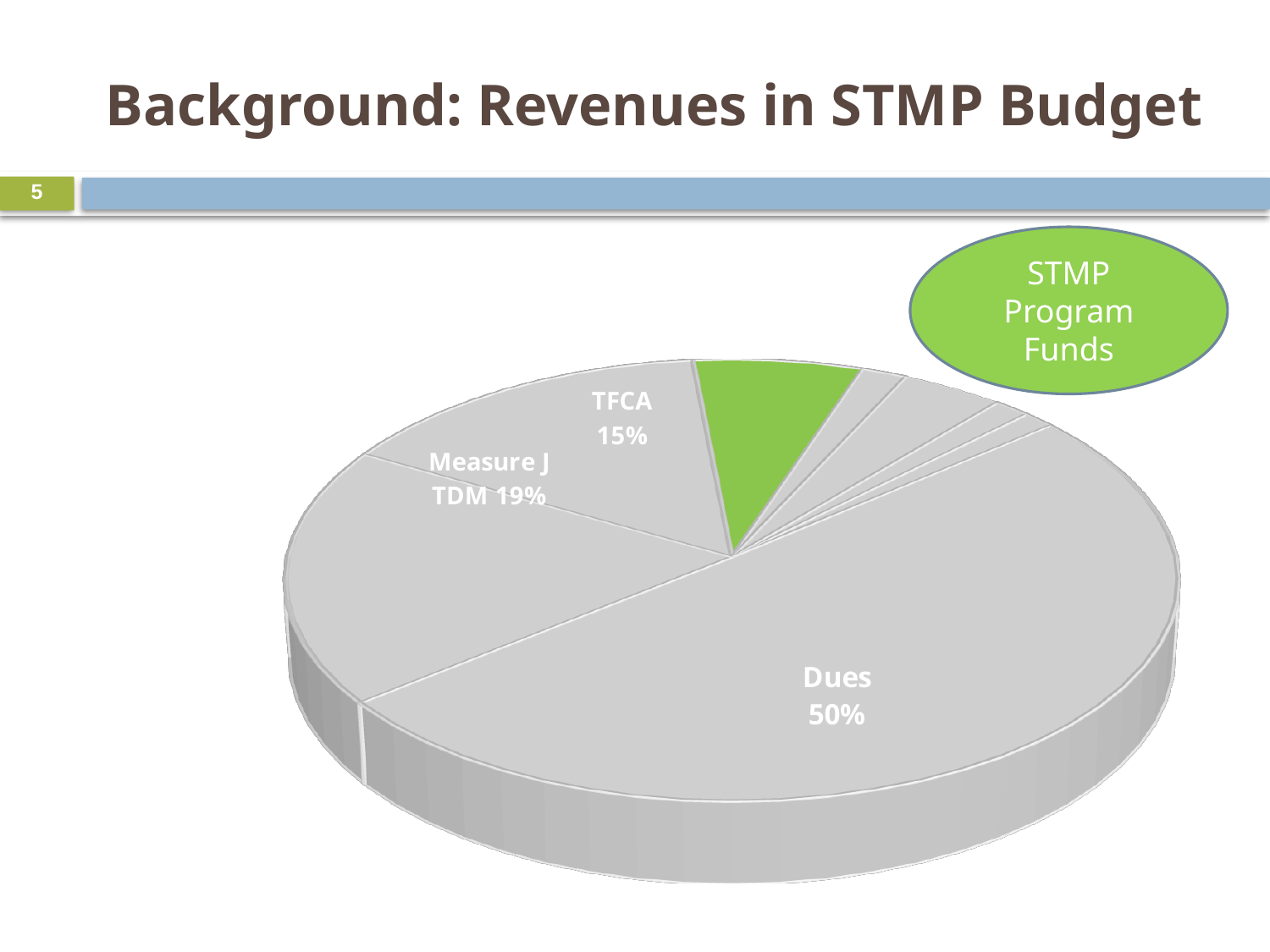
Which slice of the pie is coloured green? STMP Program Funds What share of the STMP budget revenues comes from Dues? 50% What kind of chart is shown on the slide? Pie chart Which is larger, the Measure J TDM slice or the TFCA slice? Measure J TDM Which revenue source has the largest slice of the pie? Dues What is the combined share of Dues, Measure J TDM and TFCA? 84% What percentage is shown for Measure J TDM? 19% Among the slices with printed percentages, which is the smallest? TFCA Which is larger, the Dues slice or the Measure J TDM slice? Dues What percentage is shown for TFCA? 15% What is the difference between the Measure J TDM share and the TFCA share? 4% How many percentage points larger is Dues than TFCA? 35%